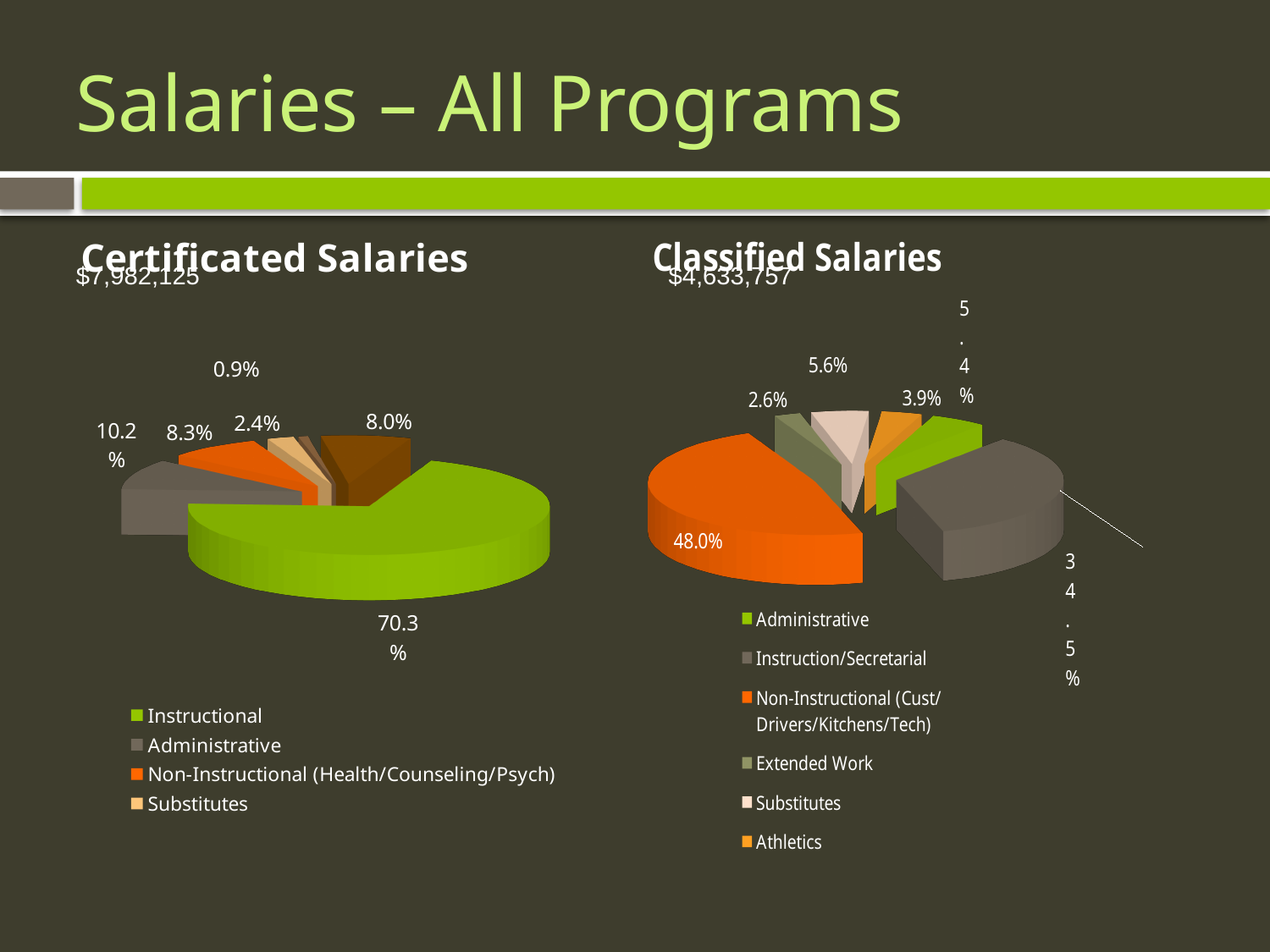
In the Certificated Salaries chart, what percentage is shown for Administrative? 10.2% In the Classified Salaries chart, how many categories does the legend list? 6 In the Classified Salaries chart, what percentage is shown for Non-Instructional (Cust/Drivers/Kitchens/Tech)? 48.0% What kind of chart is the Certificated Salaries chart? Pie chart In the Certificated Salaries chart, which category has the largest slice? Instructional In the Classified Salaries chart, which category has the smallest slice? Extended Work In the Certificated Salaries chart, what percentage is shown for Substitutes? 2.4% In the Classified Salaries chart, what percentage is shown for Instruction/Secretarial? 34.5% In the Certificated Salaries chart, what percentage is shown for Non-Instructional (Health/Counseling/Psych)? 8.3% What total dollar amount is shown under the Classified Salaries title? $4,633,757 In the Certificated Salaries chart, how many percentage points larger is Instructional than Administrative? 60.1 percentage points In the Certificated Salaries chart, what percentage is shown for Instructional? 70.3%